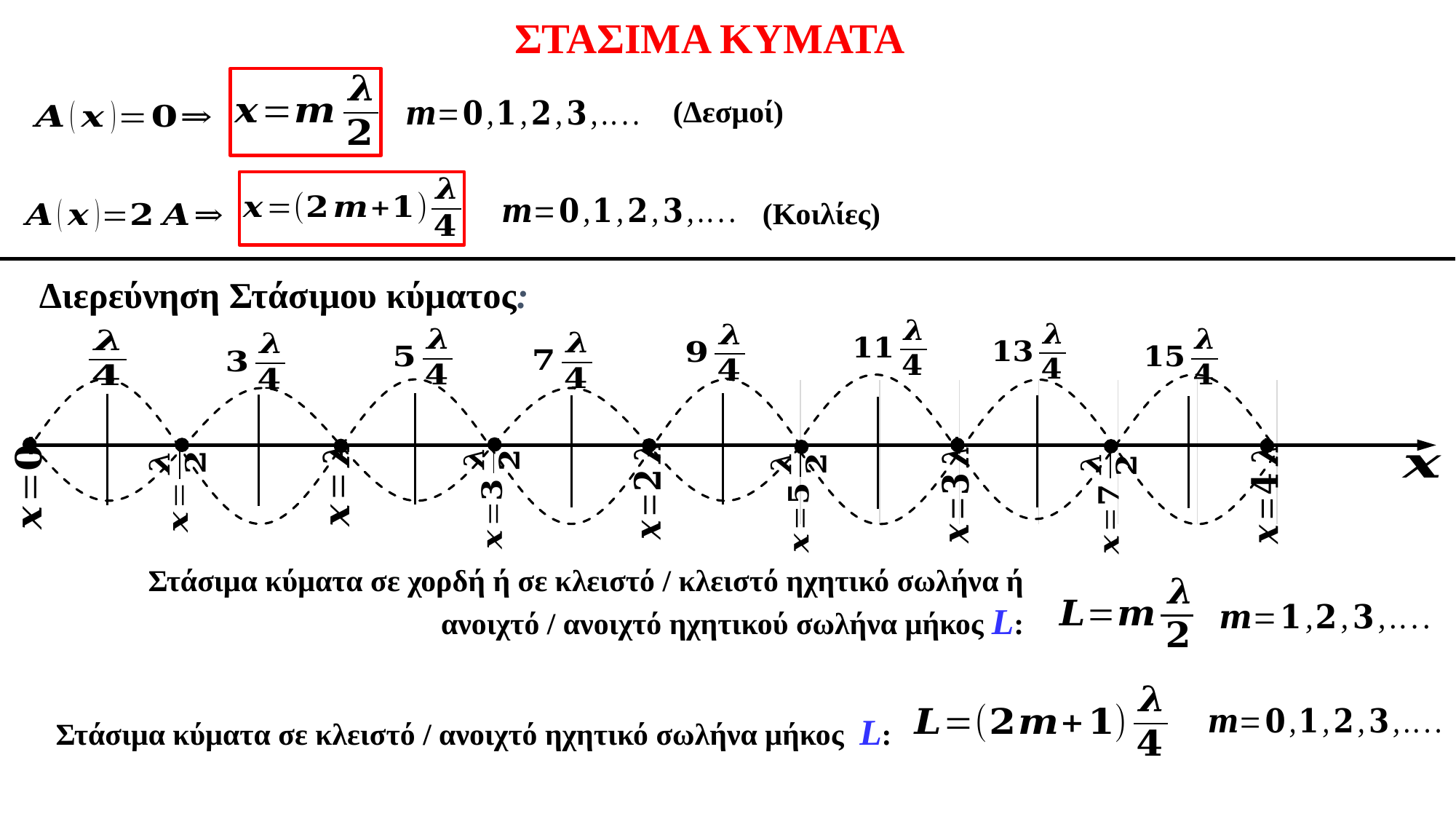
How many node positions (dots) are marked on the x axis of the standing wave diagram? 9 How many antinode positions are labelled above the standing wave diagram? 8 What is the label of the last node position on the right of the standing wave diagram? x=4λ What is the label of the last antinode position in the standing wave diagram? 15λ/4 What is the heading written above the standing wave diagram? Διερεύνηση Στάσιμου κύματος: What is the label of the first antinode position in the standing wave diagram? λ/4 What label is written at the right end of the horizontal axis of the standing wave diagram? x What is the label of the first node position on the left of the standing wave diagram? x=0